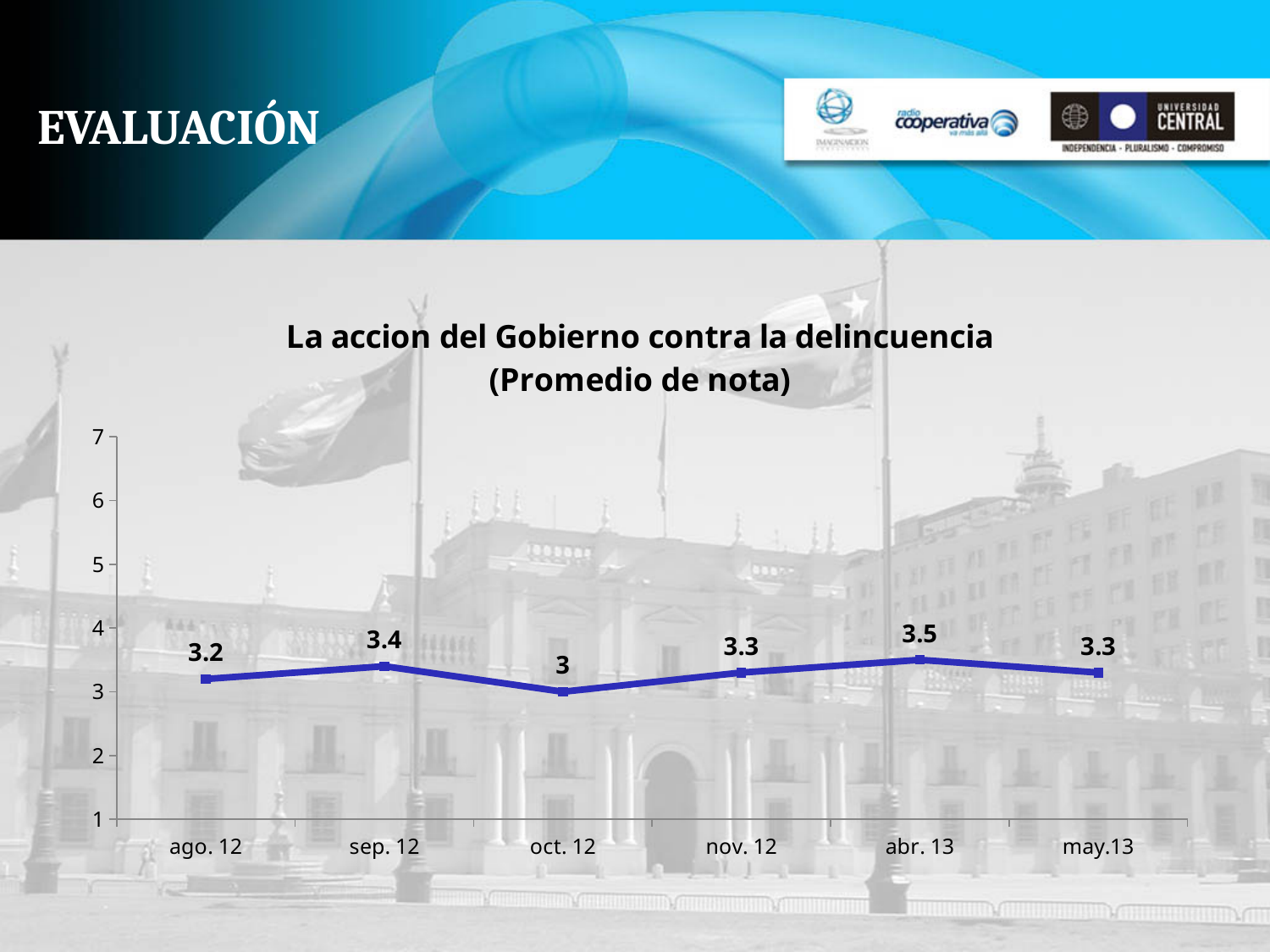
How many data points are plotted on the chart? 6 Which is larger, the value for sep. 12 or the value for ago. 12? sep. 12 What kind of chart is shown on the slide? line chart Which month has the lowest value? oct. 12 What is the value for abr. 13? 3.5 Is the value for nov. 12 greater or less than 4? less What is the value for may.13? 3.3 What is the title of the chart? La accion del Gobierno contra la delincuencia (Promedio de nota) What is the value for oct. 12? 3 What is the difference between the values for abr. 13 and oct. 12? 0.5 Which month has the highest value? abr. 13 What is the value for ago. 12? 3.2